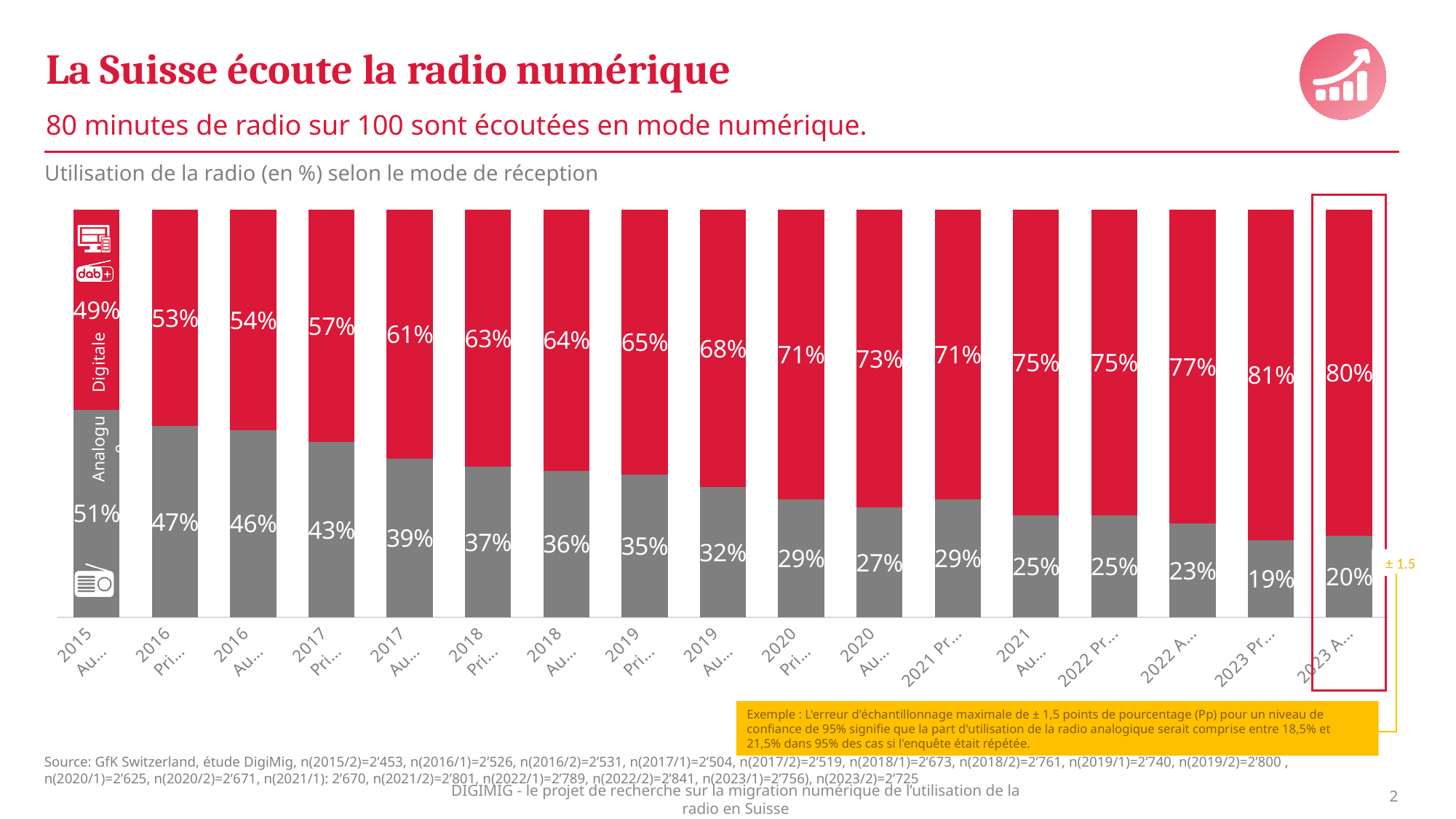
What is the total of the stacked bar for 2015 (49% digital plus 51% analogue)? 100% What kind of chart is shown on the slide? Stacked bar chart What is the digital (Digitale) share for the first bar, 2015? 49% What is the analogue share for 2023 Pr…? 19% By how many percentage points did the digital share increase from 2015 (49%) to the last bar, 2023 A… (80%)? 31 percentage points What is the analogue share for the first bar, 2015? 51% Which bar has the highest digital share? 2023 Pr… (81%) How many series are stacked in each bar of the chart? 2 (Digitale and Analogue) What is the digital share for the last bar, 2023 A…? 80% Which bar has the lowest analogue share? 2023 Pr… (19%) Does the digital share generally rise or fall from left to right across the chart? Rise How many bars (time periods) are plotted in the chart? 17